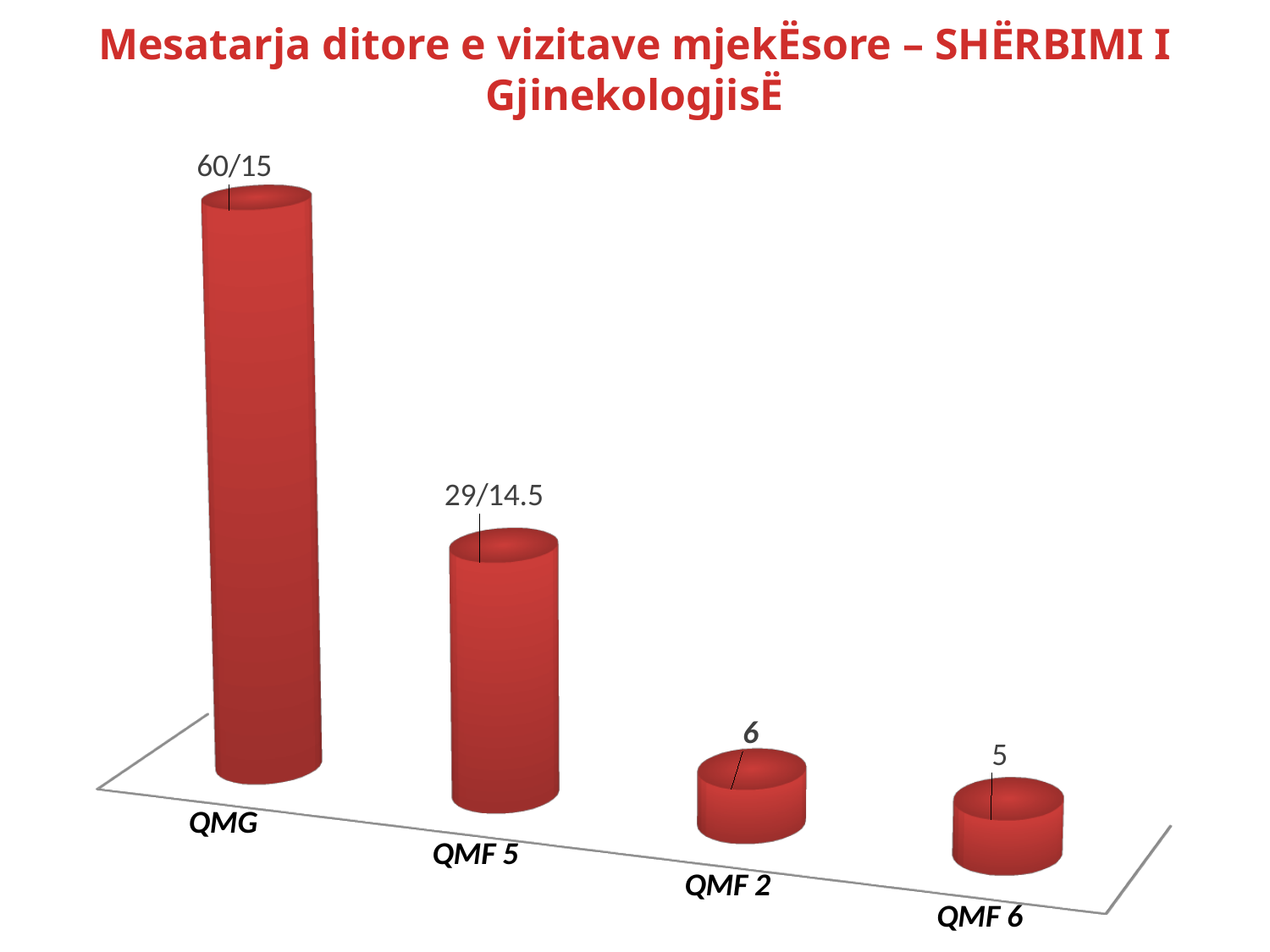
Which category has the tallest bar? QMG Do the bar heights rise or fall from left to right across the categories? Fall What kind of chart is shown on the slide? Bar chart How many categories are shown on the chart? 4 What is the data label shown for QMF 5? 29/14.5 Which is larger, the value for QMF 2 or the value for QMF 6? QMF 2 What colour are the bars on the chart? Red What is the value for QMF 6? 5 What is the value for QMF 2? 6 What is the data label shown for QMG? 60/15 What is the difference between the values for QMF 2 and QMF 6? 1